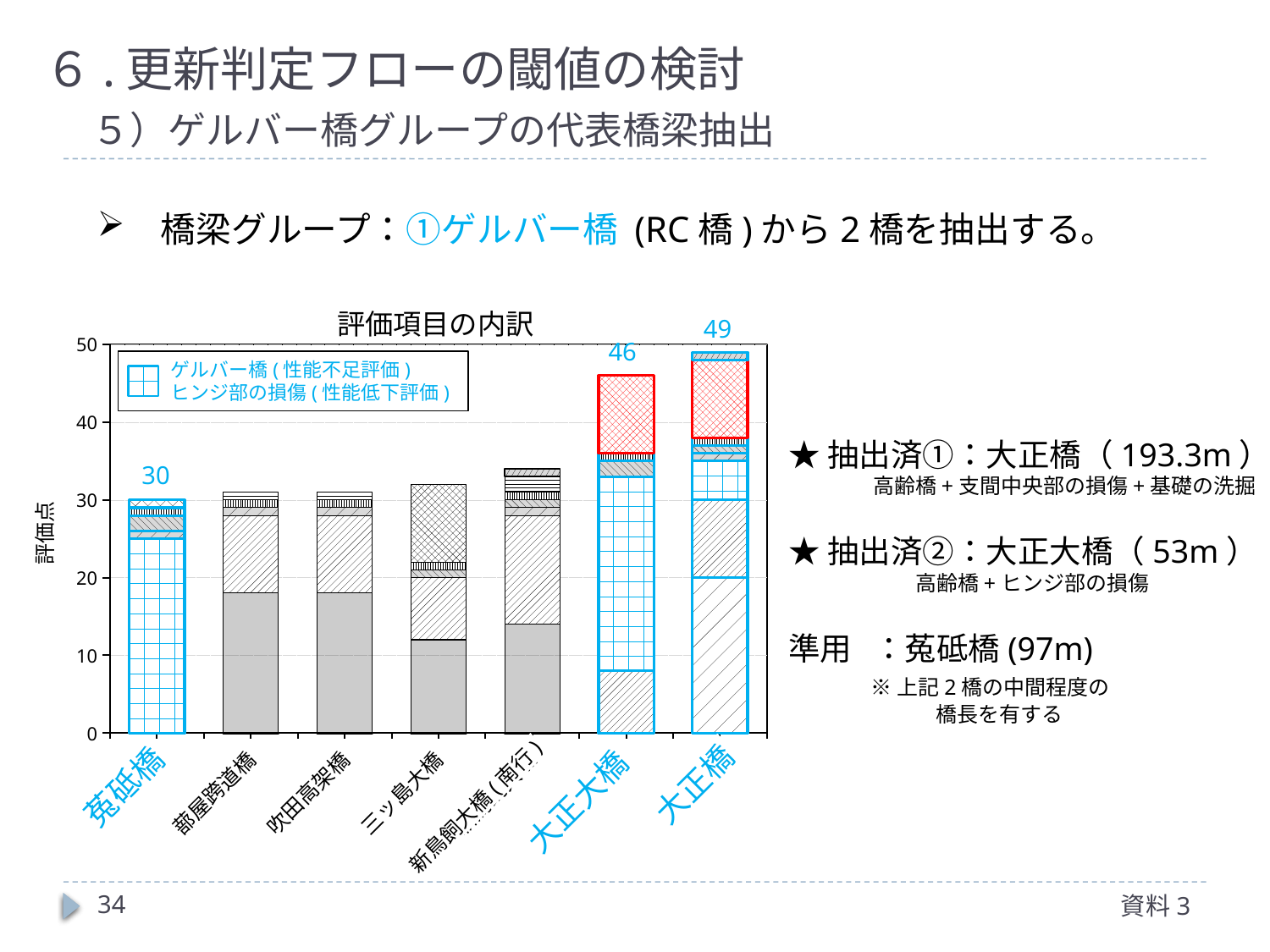
Is the total score for 三ッ島大橋 greater or less than 30? greater Which has a higher total score, 大正大橋 or 菟砥橋? 大正大橋 What is the difference between the total scores of 大正橋 and 大正大橋? 3 What is the total score shown for 菟砥橋? 30 What is the title of the chart? 評価項目の内訳 What kind of chart is shown on the slide? Stacked bar chart How many bridges are shown on the x axis of the chart? 7 What is the difference between the total scores of 大正橋 and 菟砥橋? 19 What is the total score shown for 大正橋? 49 Which bridge has the highest total score? 大正橋 What is the total score shown for 大正大橋? 46